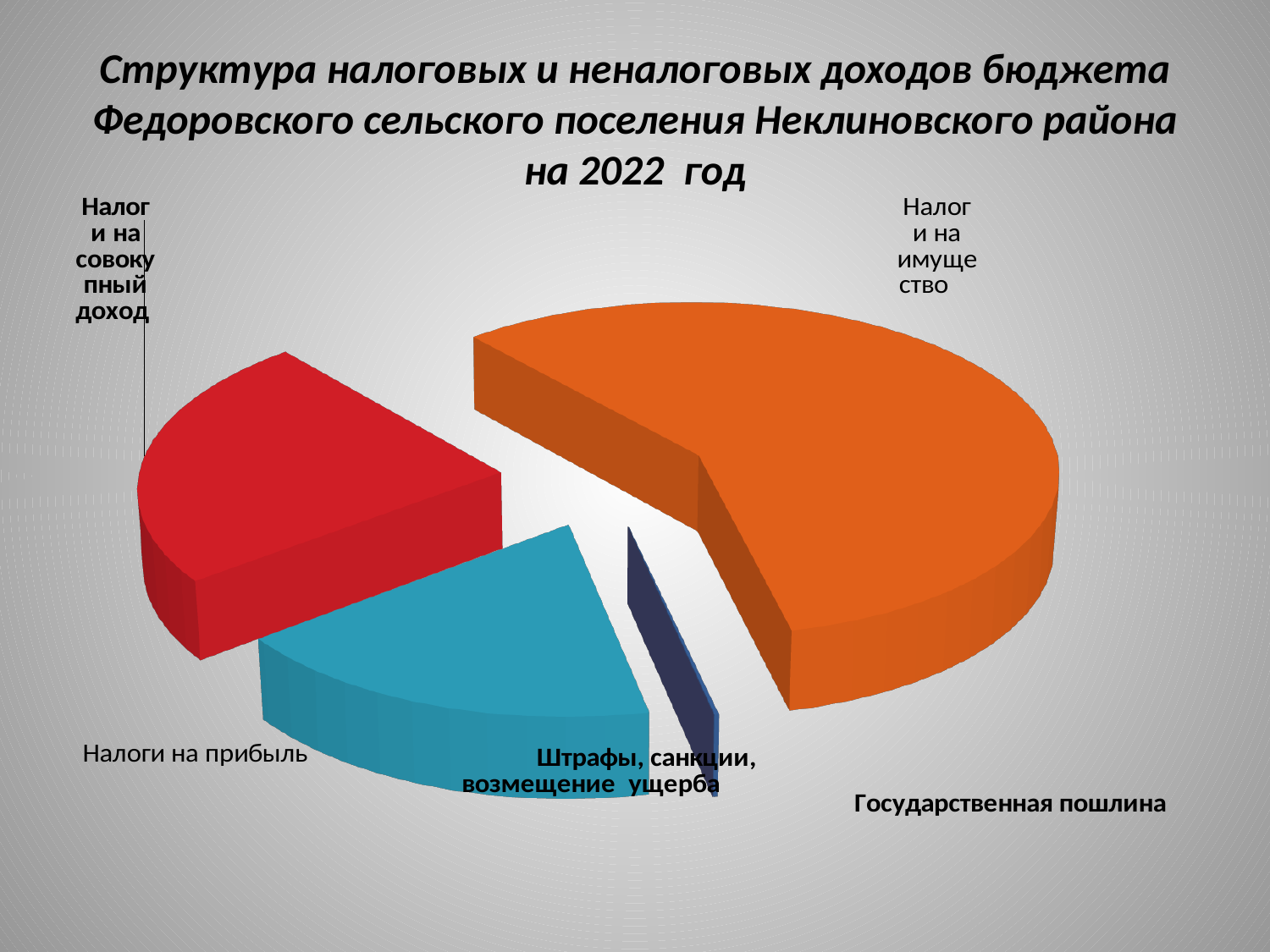
What year does the chart title refer to? 2022 Which category has the largest slice of the pie? Налоги на имущество Which is larger: the slice for Налоги на имущество or the slice for Налоги на прибыль? Налоги на имущество How many categories are labelled on the pie chart? 5 What colour is the slice for Налоги на имущество? Orange Which is larger: the slice for Налоги на прибыль or the slice for Штрафы, санкции, возмещение ущерба? Налоги на прибыль Which is larger: the slice for Налоги на совокупный доход or the slice for Штрафы, санкции, возмещение ущерба? Налоги на совокупный доход What kind of chart is shown on the slide? Pie chart